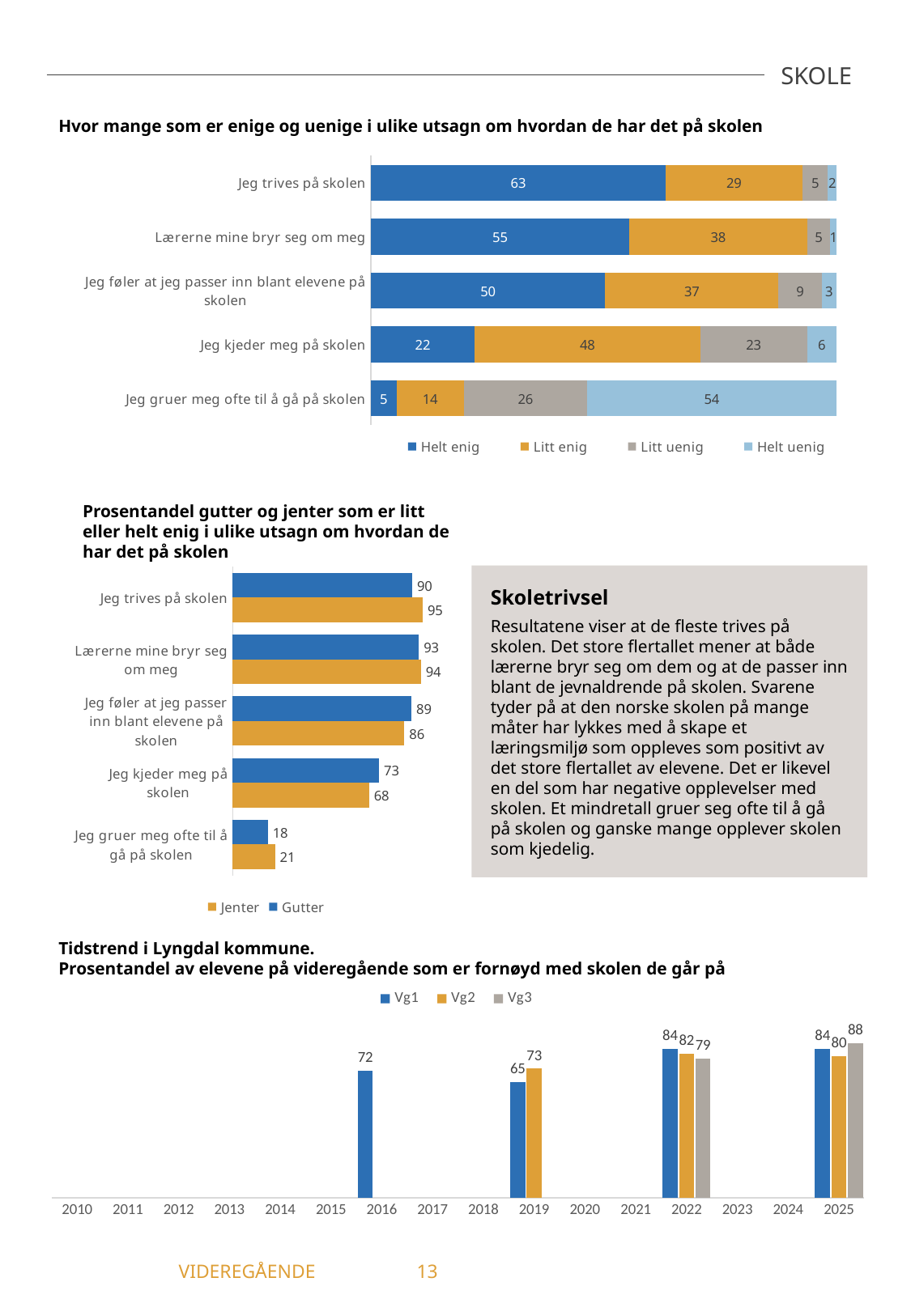
In the bottom chart 'Tidstrend i Lyngdal kommune', what is the Vg3 value for 2025? 88 In the top chart 'Hvor mange som er enige og uenige i ulike utsagn om hvordan de har det på skolen', what is the difference between the 'Helt enig' values for 'Jeg trives på skolen' and 'Lærerne mine bryr seg om meg'? 8 What kind of chart is the bottom chart 'Tidstrend i Lyngdal kommune'? Bar chart In the top chart 'Hvor mange som er enige og uenige i ulike utsagn om hvordan de har det på skolen', what is the 'Helt uenig' value for 'Jeg gruer meg ofte til å gå på skolen'? 54 In the top chart 'Hvor mange som er enige og uenige i ulike utsagn om hvordan de har det på skolen', what is the 'Helt enig' value for 'Jeg trives på skolen'? 63 In the middle chart 'Prosentandel gutter og jenter som er litt eller helt enig i ulike utsagn om hvordan de har det på skolen', what is the value for Gutter for 'Jeg kjeder meg på skolen'? 73 In the middle chart 'Prosentandel gutter og jenter som er litt eller helt enig i ulike utsagn om hvordan de har det på skolen', which is larger for 'Jeg føler at jeg passer inn blant elevene på skolen': Gutter or Jenter? Gutter In the top chart 'Hvor mange som er enige og uenige i ulike utsagn om hvordan de har det på skolen', which statement has the highest 'Litt enig' value? Jeg kjeder meg på skolen In the top chart 'Hvor mange som er enige og uenige i ulike utsagn om hvordan de har det på skolen', how many series does the legend list? 4 In the middle chart 'Prosentandel gutter og jenter som er litt eller helt enig i ulike utsagn om hvordan de har det på skolen', what is the value for Jenter for 'Jeg trives på skolen'? 95 In the middle chart 'Prosentandel gutter og jenter som er litt eller helt enig i ulike utsagn om hvordan de har det på skolen', which statement has the lowest value for Gutter? Jeg gruer meg ofte til å gå på skolen In the bottom chart 'Tidstrend i Lyngdal kommune', what is the difference between the Vg2 values for 2019 and 2022? 9